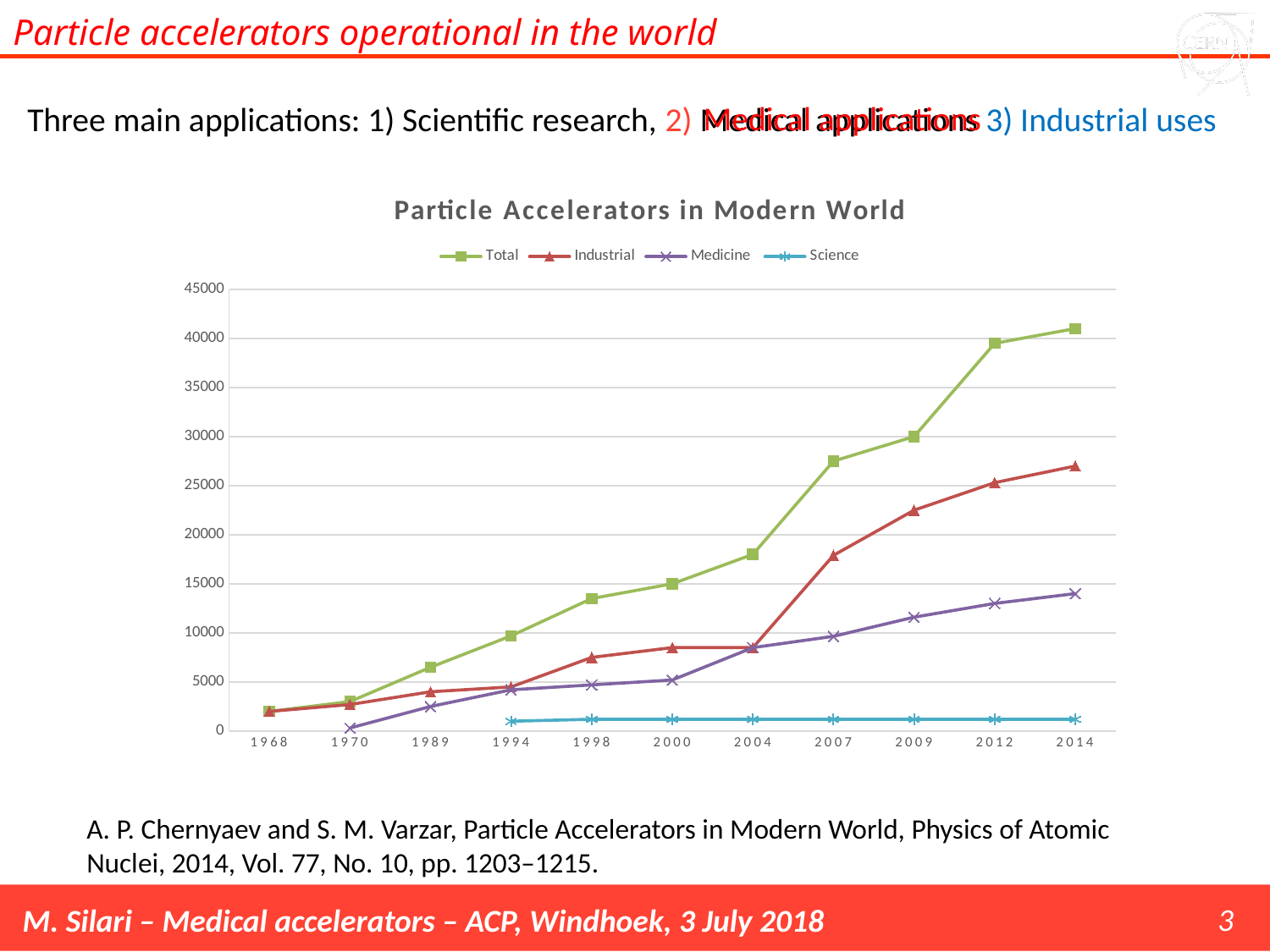
What is the title of the chart? Particle Accelerators in Modern World What kind of chart is shown on the slide? line chart Does the Total series rise or fall from 1968 to 2014? rise Is the value for Medicine in 2014 greater or less than 15000? less Is the value for Industrial in 2014 greater or less than 25000? greater Is the value for Total in 2014 greater or less than 40000? greater Which series is plotted with the green line and square markers? Total In 2014, which is larger, the Industrial value or the Medicine value? Industrial How many series does the legend list? 4 How many years are shown along the x axis? 11 In which year does the Total series reach its highest value? 2014